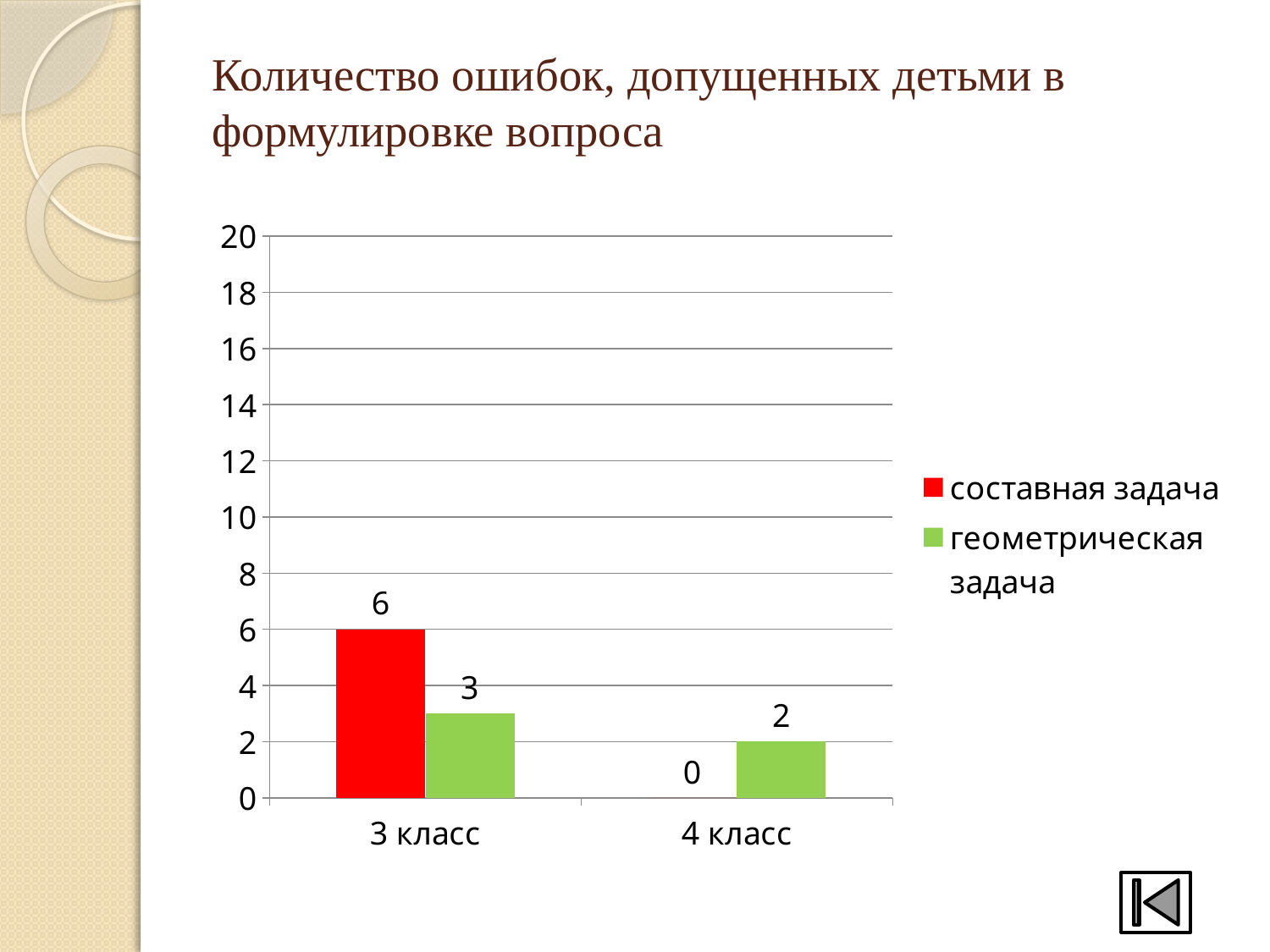
How many categories are shown on the x axis? 2 Which is larger in 3 класс: составная задача or геометрическая задача? составная задача How many series does the legend list? 2 What is the value for геометрическая задача in 4 класс? 2 What is the value for составная задача in 3 класс? 6 What is the value for геометрическая задача in 3 класс? 3 Which category has the highest value for составная задача? 3 класс What is the difference between составная задача and геометрическая задача in 3 класс? 3 Which category has the lowest value for геометрическая задача? 4 класс What colour represents геометрическая задача in the legend? green What kind of chart is shown on the slide? bar chart What is the value for составная задача in 4 класс? 0